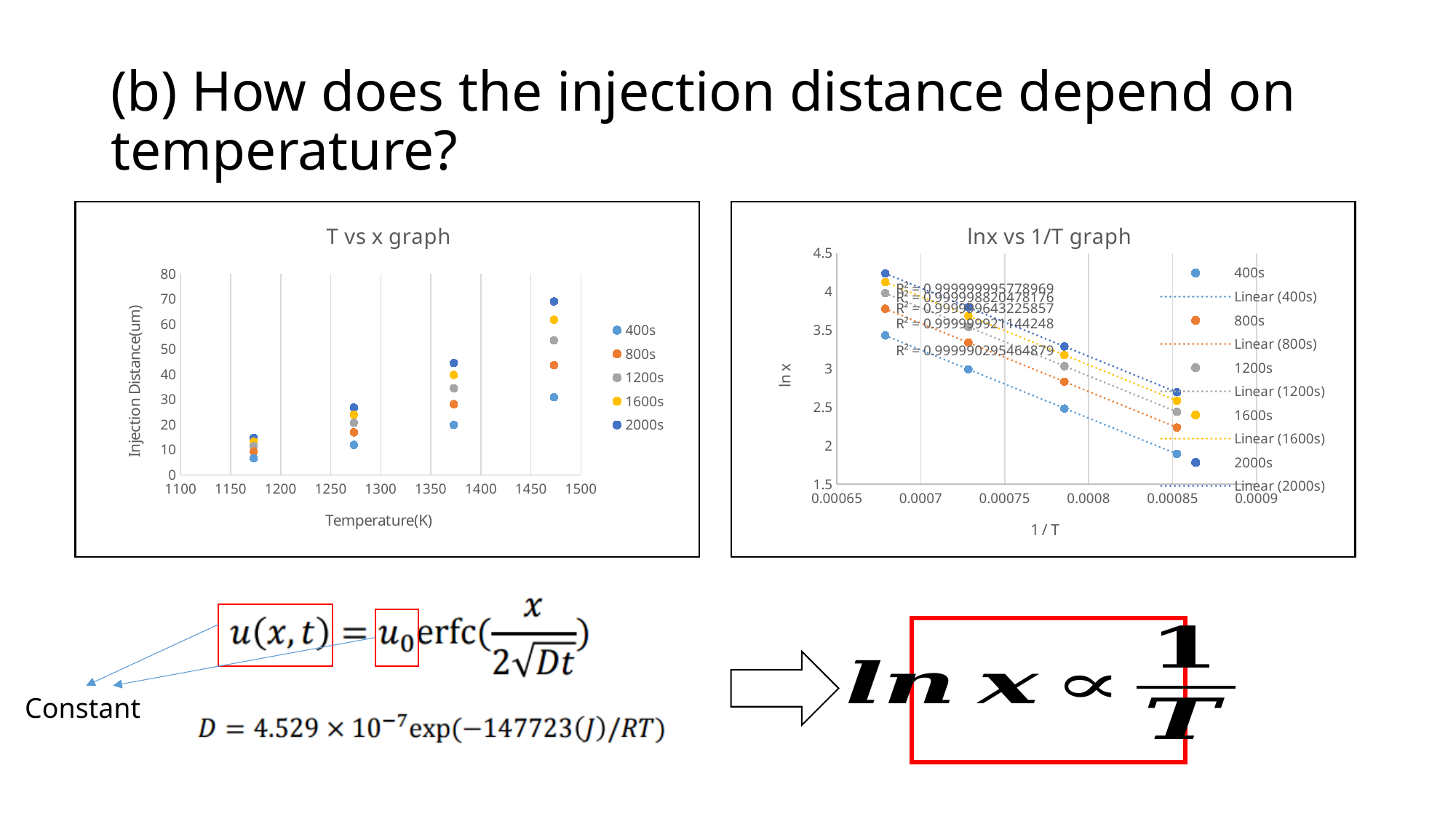
How many entries does the legend of the "lnx vs 1/T graph" list? 10 In the "T vs x graph", is the 400s value at the highest temperature greater or less than 40? less In the "T vs x graph", which series has the highest injection distance at the highest temperature? 2000s In the "lnx vs 1/T graph", is the 400s value at 1/T = 0.00085 greater or less than 2? less In the "T vs x graph", is the 2000s value at the highest temperature greater or less than 60? greater In the "T vs x graph", how many data points does each series have? 4 What is the label of the x axis of the "T vs x graph"? Temperature(K) How many series does the legend of the "T vs x graph" list? 5 In the "T vs x graph", which series has the lowest injection distance at the highest temperature? 400s In the "T vs x graph", does the injection distance rise or fall as temperature increases? rise What type of chart is the "T vs x graph"? scatter chart In the "lnx vs 1/T graph", does ln x rise or fall as 1/T increases? fall